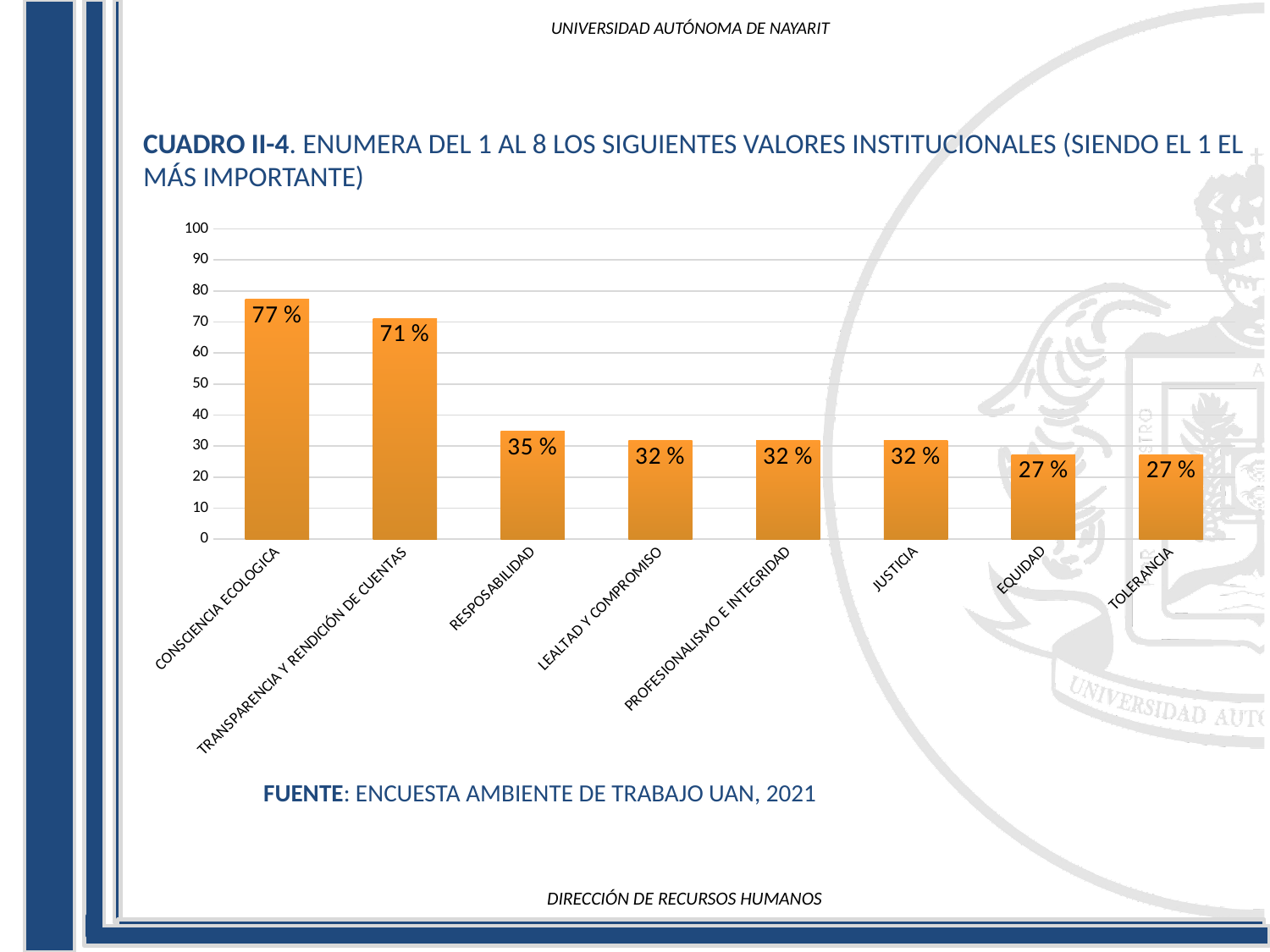
How many categories are shown on the x axis? 8 Which category has the highest value? CONSCIENCIA ECOLOGICA What is the value for JUSTICIA? 32 % What kind of chart is shown on the slide? bar chart What is the value for TOLERANCIA? 27 % Which is larger, the value for RESPOSABILIDAD or the value for EQUIDAD? RESPOSABILIDAD What is the value for RESPOSABILIDAD? 35 % What is the difference between the values for CONSCIENCIA ECOLOGICA and TRANSPARENCIA Y RENDICIÓN DE CUENTAS? 6 % What is the value for TRANSPARENCIA Y RENDICIÓN DE CUENTAS? 71 % Is the value for LEALTAD Y COMPROMISO greater or less than 40? less What is the source cited below the chart? ENCUESTA AMBIENTE DE TRABAJO UAN, 2021 What is the value for CONSCIENCIA ECOLOGICA? 77 %